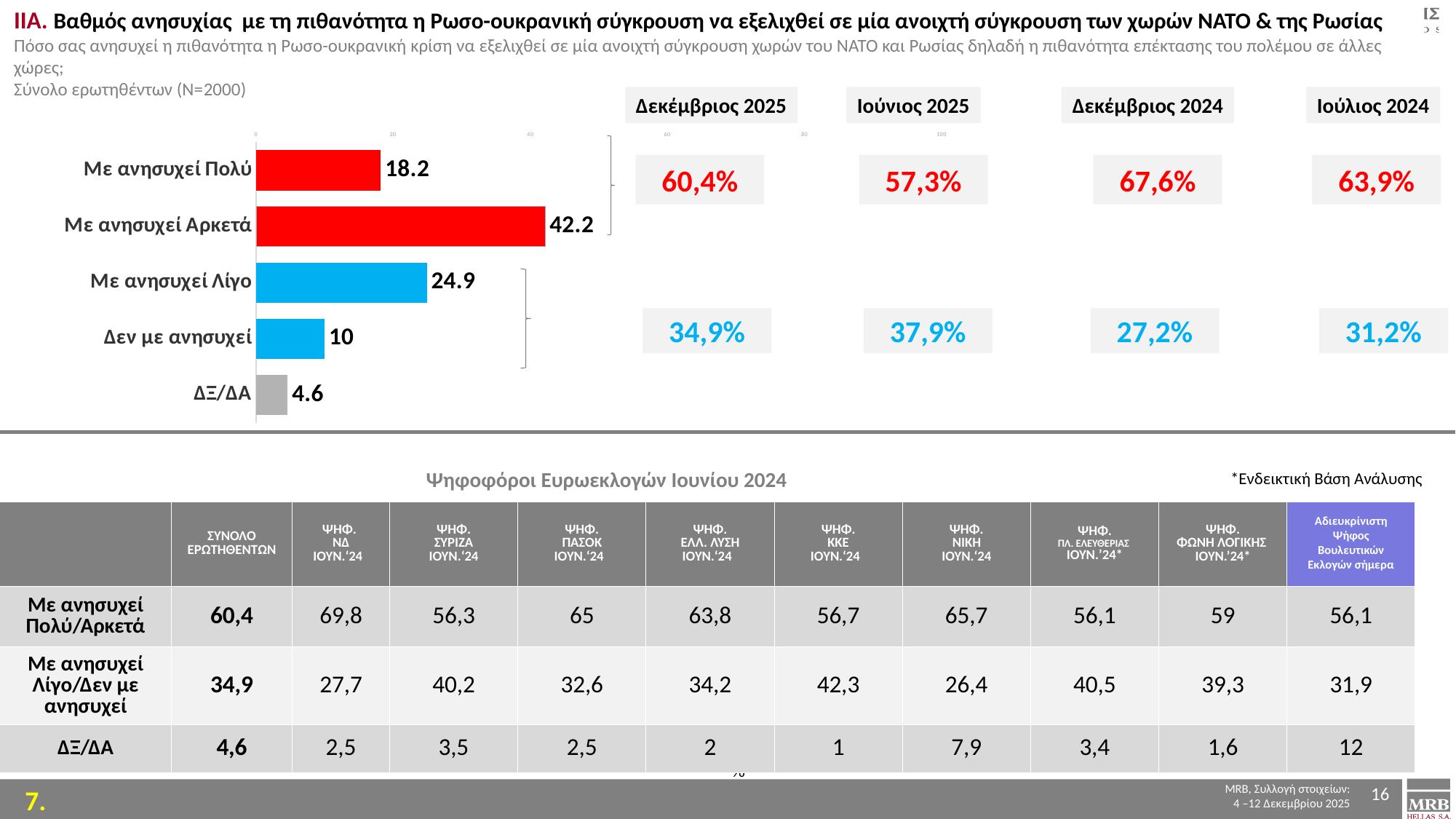
Which category has the highest value in the bar chart? Με ανησυχεί Αρκετά What is the difference between the values for Με ανησυχεί Αρκετά and Με ανησυχεί Λίγο in the bar chart? 17.3 What is the value for Δεν με ανησυχεί in the bar chart? 10 What kind of chart is shown on the slide? bar chart Is the value for Με ανησυχεί Αρκετά in the bar chart greater or less than 40? greater What is the total of the values for Με ανησυχεί Πολύ and Με ανησυχεί Αρκετά in the bar chart? 60.4 How many categories are shown in the bar chart? 5 What is the value for Με ανησυχεί Πολύ in the bar chart? 18.2 Which is larger in the bar chart, Με ανησυχεί Λίγο or Με ανησυχεί Πολύ? Με ανησυχεί Λίγο What is the value for ΔΞ/ΔΑ in the bar chart? 4.6 Which category has the lowest value in the bar chart? ΔΞ/ΔΑ What is the value for Με ανησυχεί Αρκετά in the bar chart? 42.2